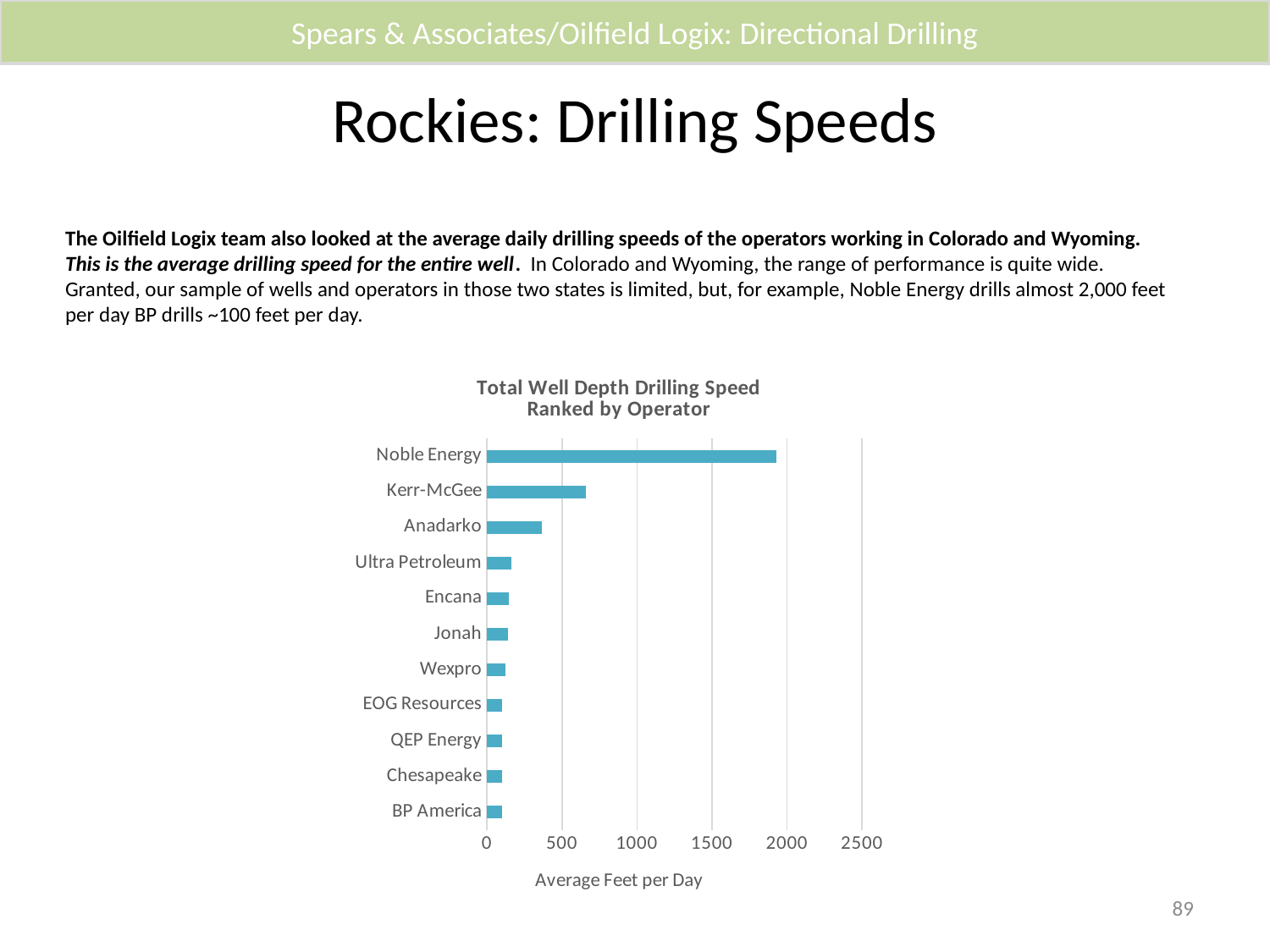
Is the value for Anadarko greater or less than 500? less Is the value for Kerr-McGee greater or less than 1000? less Is the value for Noble Energy greater or less than 2000? less What kind of chart is shown on the slide? Bar chart Which has a higher average feet per day, Kerr-McGee or Anadarko? Kerr-McGee What is the label on the horizontal axis of the chart? Average Feet per Day Which operator has the highest average feet per day? Noble Energy How many operators are listed in the chart? 11 What is the title of the chart? Total Well Depth Drilling Speed Ranked by Operator Which has a higher average feet per day, Anadarko or Ultra Petroleum? Anadarko